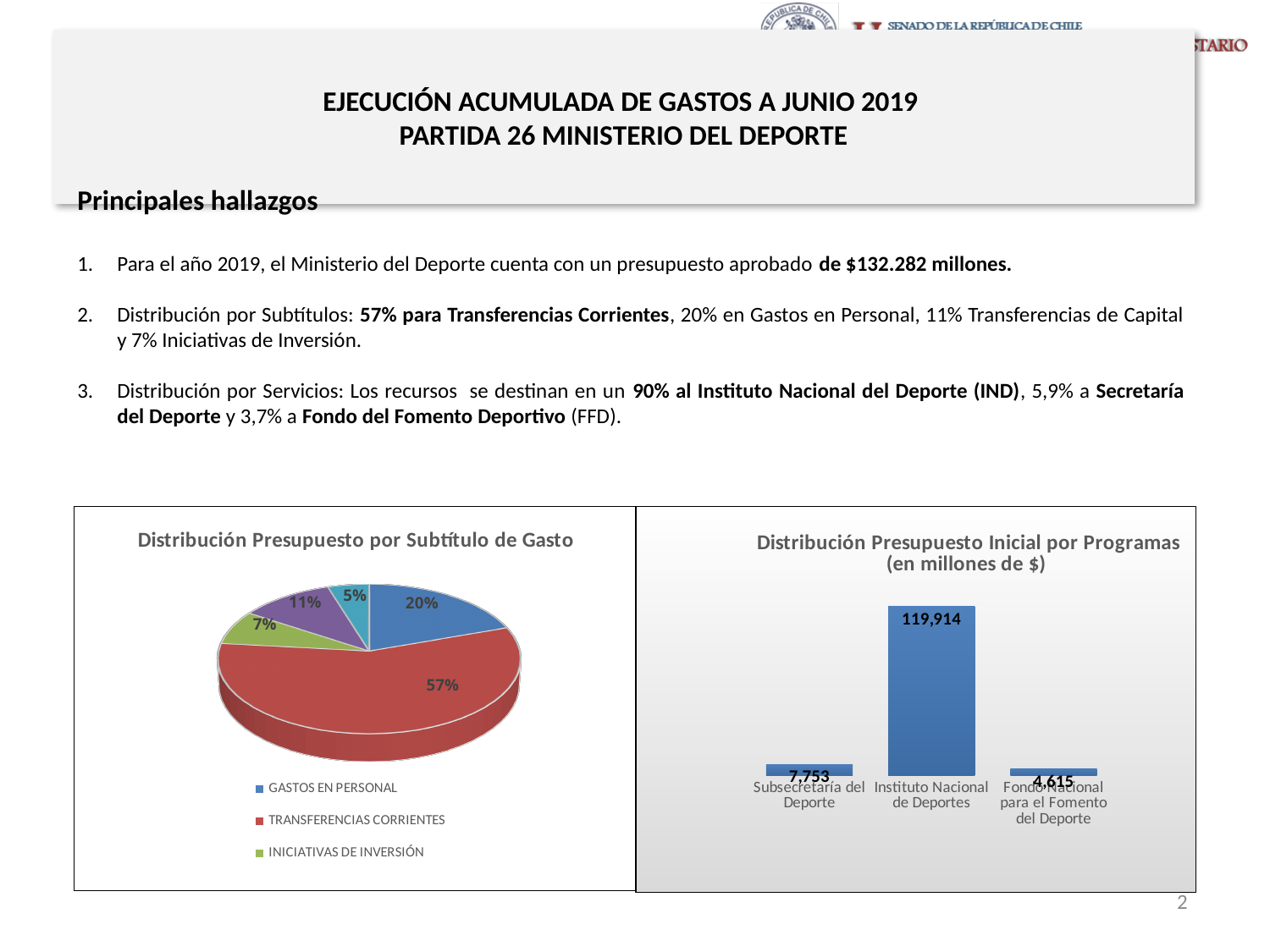
In the bar chart 'Distribución Presupuesto Inicial por Programas', which program has the highest value? Instituto Nacional de Deportes In the bar chart 'Distribución Presupuesto Inicial por Programas', what is the value for Fondo Nacional para el Fomento del Deporte? 4,615 In the pie chart 'Distribución Presupuesto por Subtítulo de Gasto', which is larger: Gastos en Personal or Iniciativas de Inversión? Gastos en Personal In the bar chart 'Distribución Presupuesto Inicial por Programas', what is the difference between the values for Subsecretaría del Deporte and Fondo Nacional para el Fomento del Deporte? 3,138 What kind of chart is 'Distribución Presupuesto Inicial por Programas'? bar chart In the bar chart 'Distribución Presupuesto Inicial por Programas', what is the value for Instituto Nacional de Deportes? 119,914 In the pie chart 'Distribución Presupuesto por Subtítulo de Gasto', what share does Gastos en Personal have? 20% In the bar chart 'Distribución Presupuesto Inicial por Programas', what is the value for Subsecretaría del Deporte? 7,753 In the bar chart 'Distribución Presupuesto Inicial por Programas', how many programs are shown? 3 In the bar chart 'Distribución Presupuesto Inicial por Programas', which program has the lowest value? Fondo Nacional para el Fomento del Deporte In the pie chart 'Distribución Presupuesto por Subtítulo de Gasto', which category has the largest slice? Transferencias Corrientes In the pie chart 'Distribución Presupuesto por Subtítulo de Gasto', what share does Transferencias Corrientes have? 57%